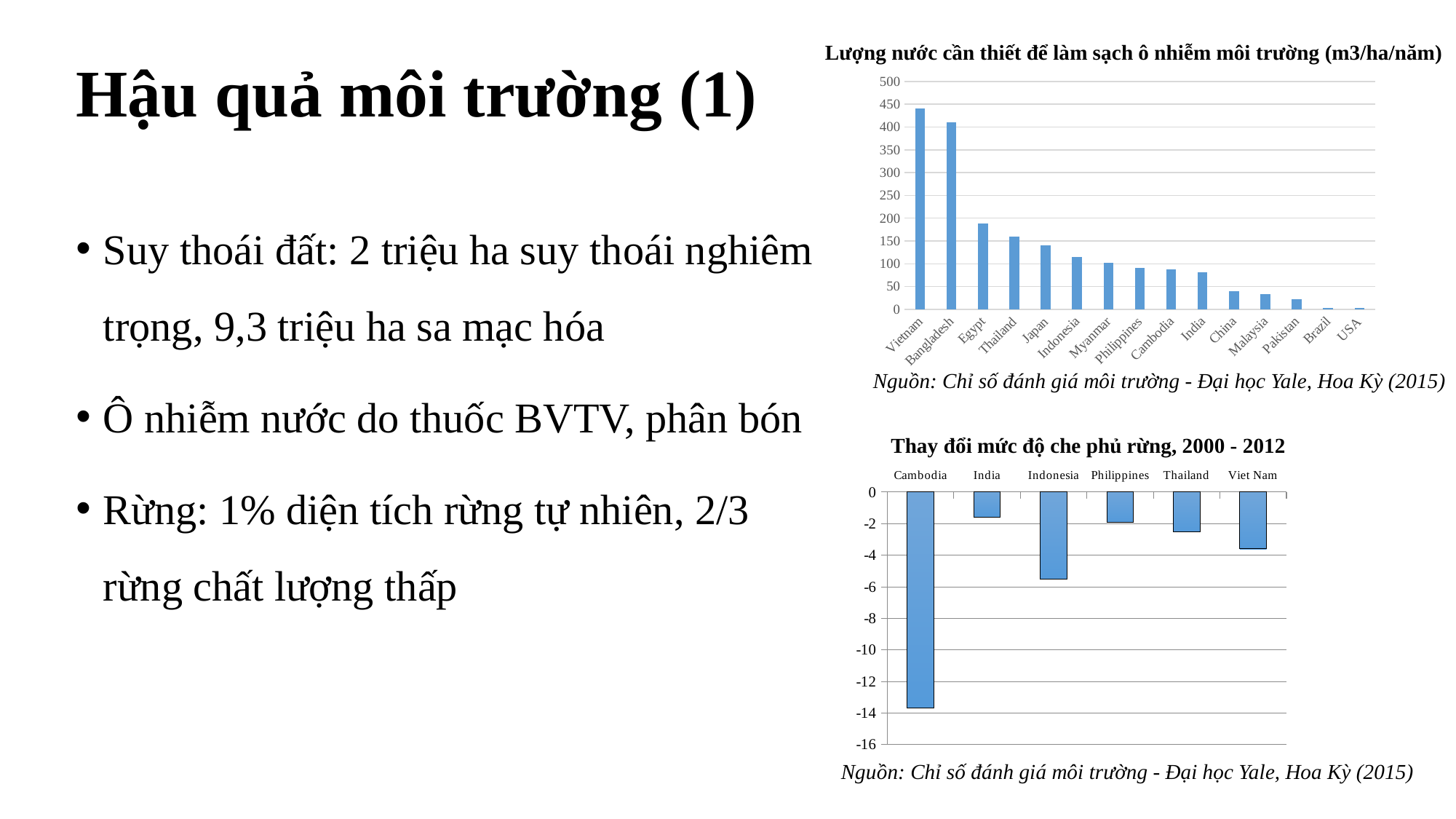
In the top chart, 'Lượng nước cần thiết để làm sạch ô nhiễm môi trường', which has a larger value, Egypt or Thailand? Egypt What kind of chart is the bottom chart, 'Thay đổi mức độ che phủ rừng, 2000 - 2012'? Bar chart In the bottom chart, 'Thay đổi mức độ che phủ rừng, 2000 - 2012', how many countries are shown? 6 In the bottom chart, 'Thay đổi mức độ che phủ rừng, 2000 - 2012', is the value for Cambodia greater or less than -12? less What kind of chart is the top chart, 'Lượng nước cần thiết để làm sạch ô nhiễm môi trường'? Bar chart In the top chart, 'Lượng nước cần thiết để làm sạch ô nhiễm môi trường', is the value for Vietnam greater or less than 400? greater In the top chart, 'Lượng nước cần thiết để làm sạch ô nhiễm môi trường', how many countries are shown? 15 In the bottom chart, 'Thay đổi mức độ che phủ rừng, 2000 - 2012', which country has the lowest (most negative) value? Cambodia In the top chart, 'Lượng nước cần thiết để làm sạch ô nhiễm môi trường', do the values rise or fall from left to right along the x axis? Fall In the top chart, 'Lượng nước cần thiết để làm sạch ô nhiễm môi trường', which country has the highest value? Vietnam In the bottom chart, 'Thay đổi mức độ che phủ rừng, 2000 - 2012', which has a larger (less negative) value, Indonesia or Viet Nam? Viet Nam In the top chart, 'Lượng nước cần thiết để làm sạch ô nhiễm môi trường', is the value for India greater or less than 100? less